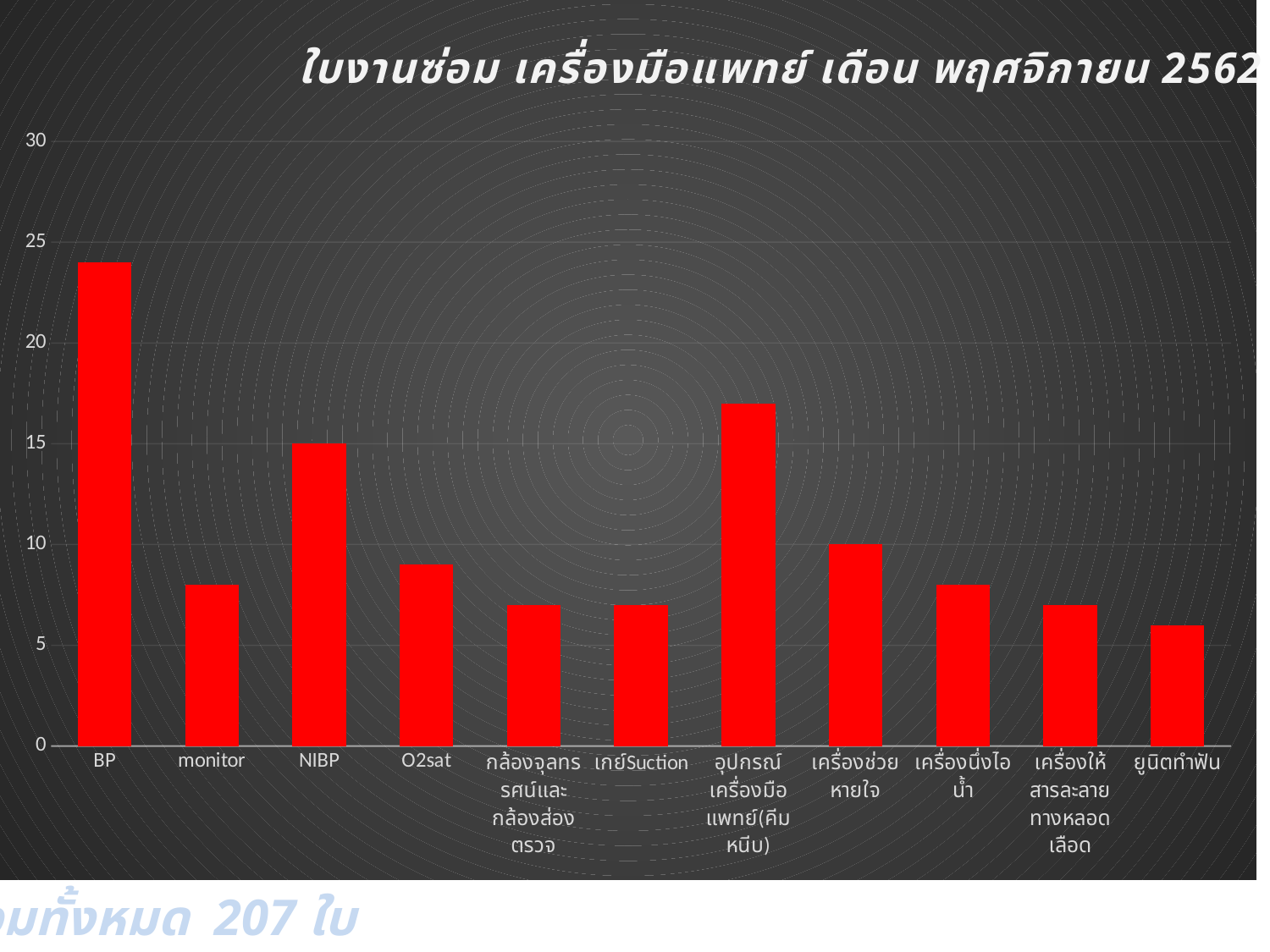
Is the value for monitor greater or less than 10? less Is the value for BP greater or less than 20? greater What kind of chart is shown on the slide? bar chart Which category has the highest bar in the chart? BP Is the value for อุปกรณ์เครื่องมือแพทย์(คีมหนีบ) greater or less than 15? greater How many categories are shown on the x axis of the chart? 11 What is the value for เครื่องช่วยหายใจ? 10 What is the difference between the values for NIBP and เครื่องช่วยหายใจ? 5 What colour are the bars in the chart? red Which is larger, the value for BP or the value for อุปกรณ์เครื่องมือแพทย์(คีมหนีบ)? BP What is the value for NIBP? 15